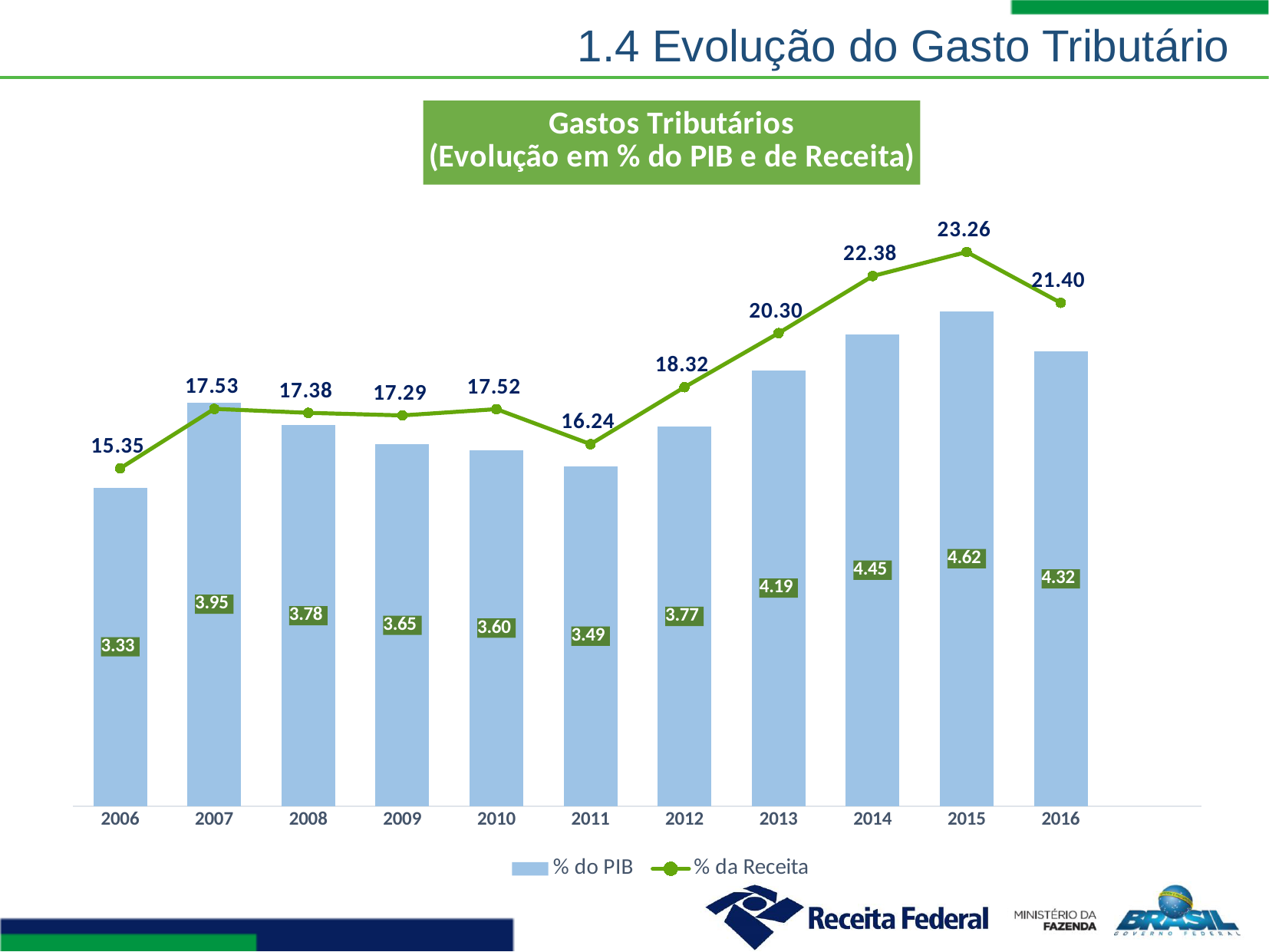
What is the value of % da Receita for 2011? 16.24 How many years are shown on the x axis? 11 What is the difference between the % da Receita values for 2015 and 2016? 1.86 Which year has the highest % do PIB value? 2015 What kind of chart is this? Combined bar and line chart What is the value of % da Receita for 2015? 23.26 Which year has the lowest % da Receita value? 2006 What is the value of % do PIB for 2006? 3.33 Does the % da Receita series rise or fall from 2011 to 2015? Rise Which is larger, the % do PIB value for 2007 or for 2012? 2007 Which series is shown as a green line with markers? % da Receita How many series does the legend list? 2